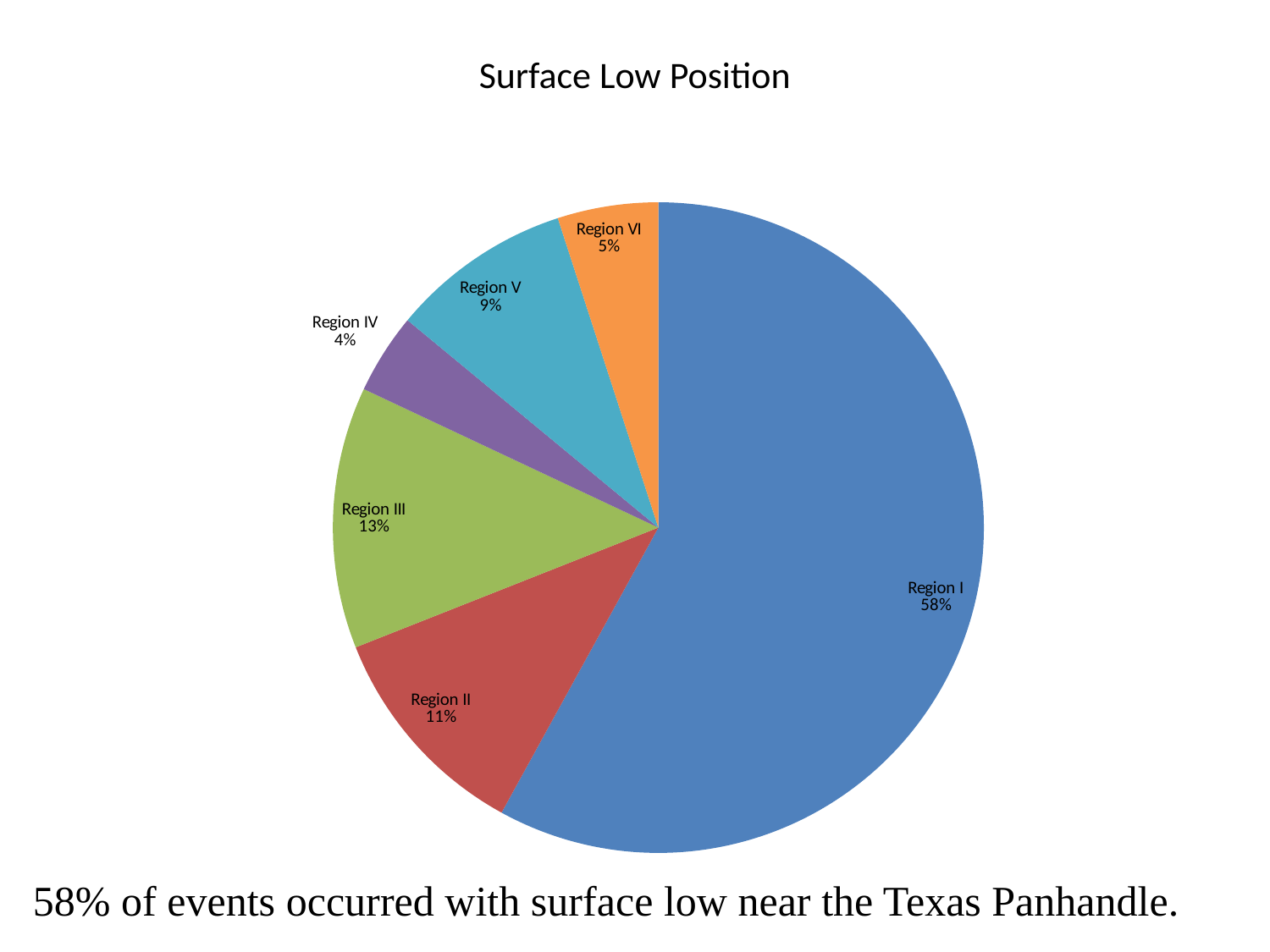
What percentage is shown for Region III? 13% What is the difference in percentage points between Region III and Region II? 2 How many slices does the pie chart have? 6 What is the difference in percentage points between Region I and Region III? 45 Which region has the largest slice of the pie? Region I Which region has the smallest slice of the pie? Region IV What share of the pie does Region I represent? 58% Which is larger, the share for Region V or the share for Region VI? Region V What colour is the Region I slice? blue What type of chart is shown on the slide? pie chart What is the title of the chart? Surface Low Position What percentage is shown for Region V? 9%